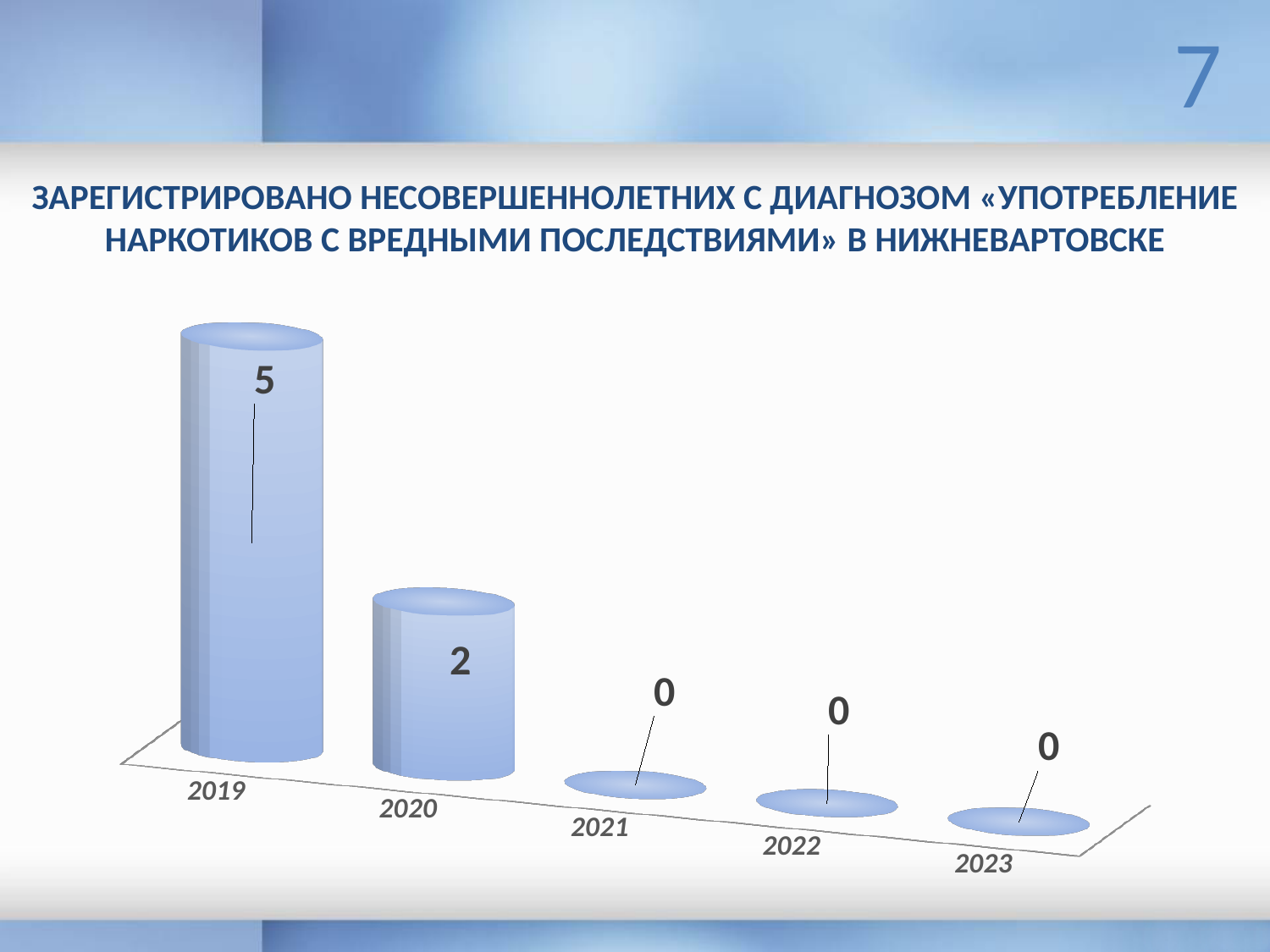
Do the values rise or fall from 2019 to 2021? fall What is the difference between the values for 2019 and 2020? 3 What is the value for 2019? 5 What kind of chart is this? bar chart What is the value for 2021? 0 What is the first year shown on the x axis? 2019 What is the value for 2023? 0 Which is larger, the value for 2019 or the value for 2020? 2019 What is the value for 2020? 2 How many years have a value of 0? 3 Which year has the highest value? 2019 How many years are shown on the chart? 5